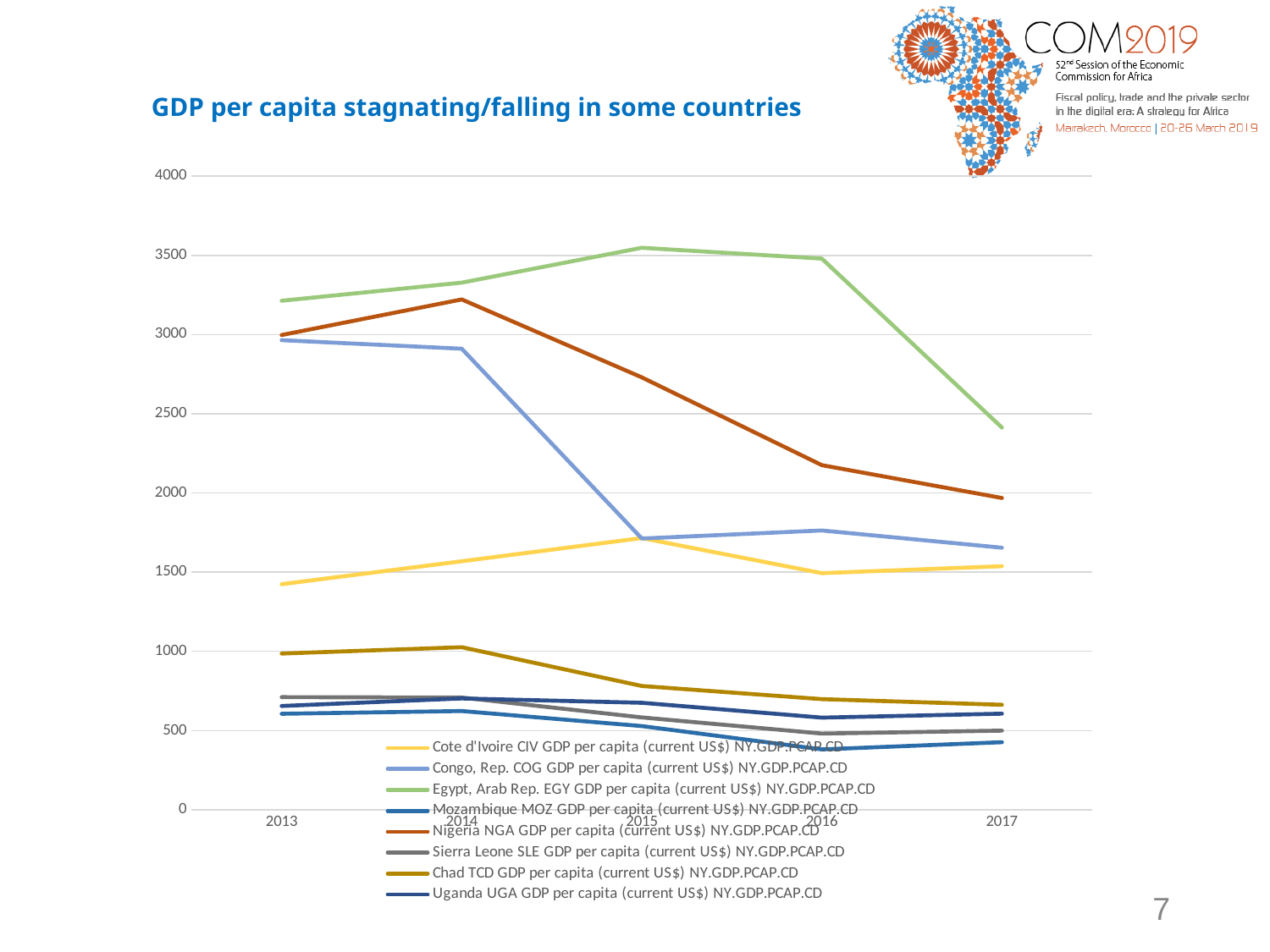
Is the value for Congo, Rep. in 2015 greater or less than 1500? greater Which country has the highest GDP per capita in 2017? Egypt, Arab Rep. Does the value for Nigeria rise or fall from 2014 to 2017? fall Which is larger in 2014, the value for Congo, Rep. or the value for Cote d'Ivoire? Congo, Rep. How many series does the legend list? 8 What is the title of the chart? GDP per capita stagnating/falling in some countries What kind of chart is shown on the slide? line chart How many years are shown along the x axis? 5 Is the value for Nigeria in 2016 greater or less than 2500? less Which country has the highest GDP per capita in 2015? Egypt, Arab Rep. Is the value for Chad in 2015 greater or less than 1000? less